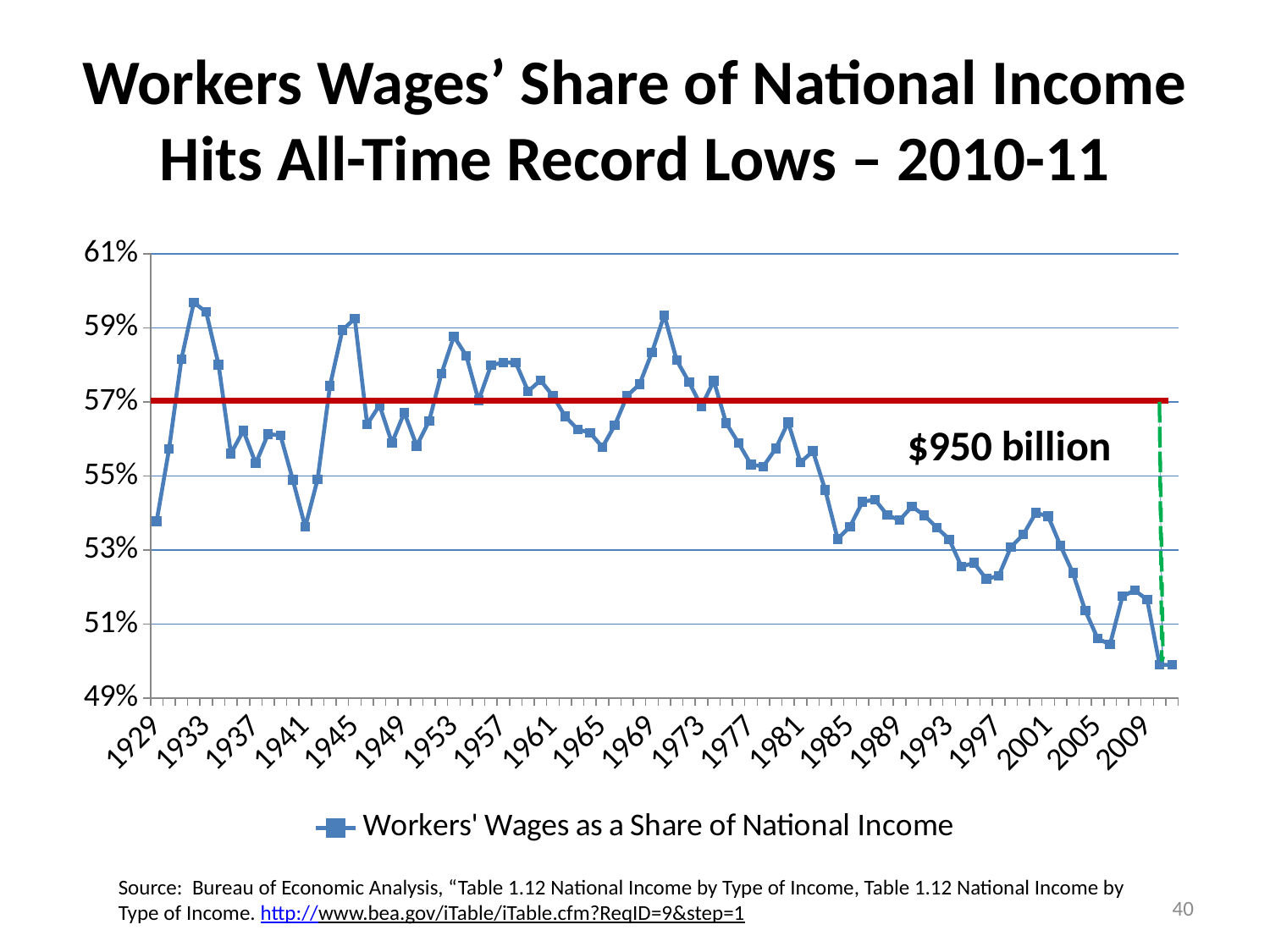
What kind of chart is shown on the slide? line chart In which period does the series reach its lowest value? 2010-11 Is the value for 1997 greater or less than 53%? less Is the value for 1945 greater or less than 57%? greater At what percentage level is the horizontal red line drawn? 57% Is the value for 1933 greater or less than 57%? greater Does the series overall rise or fall from 1985 to the end of the chart? fall How many series does the legend list? 1 What dollar amount is annotated on the chart next to the green dashed line? $950 billion Which is larger, the value for 1933 or the value for 1929? 1933